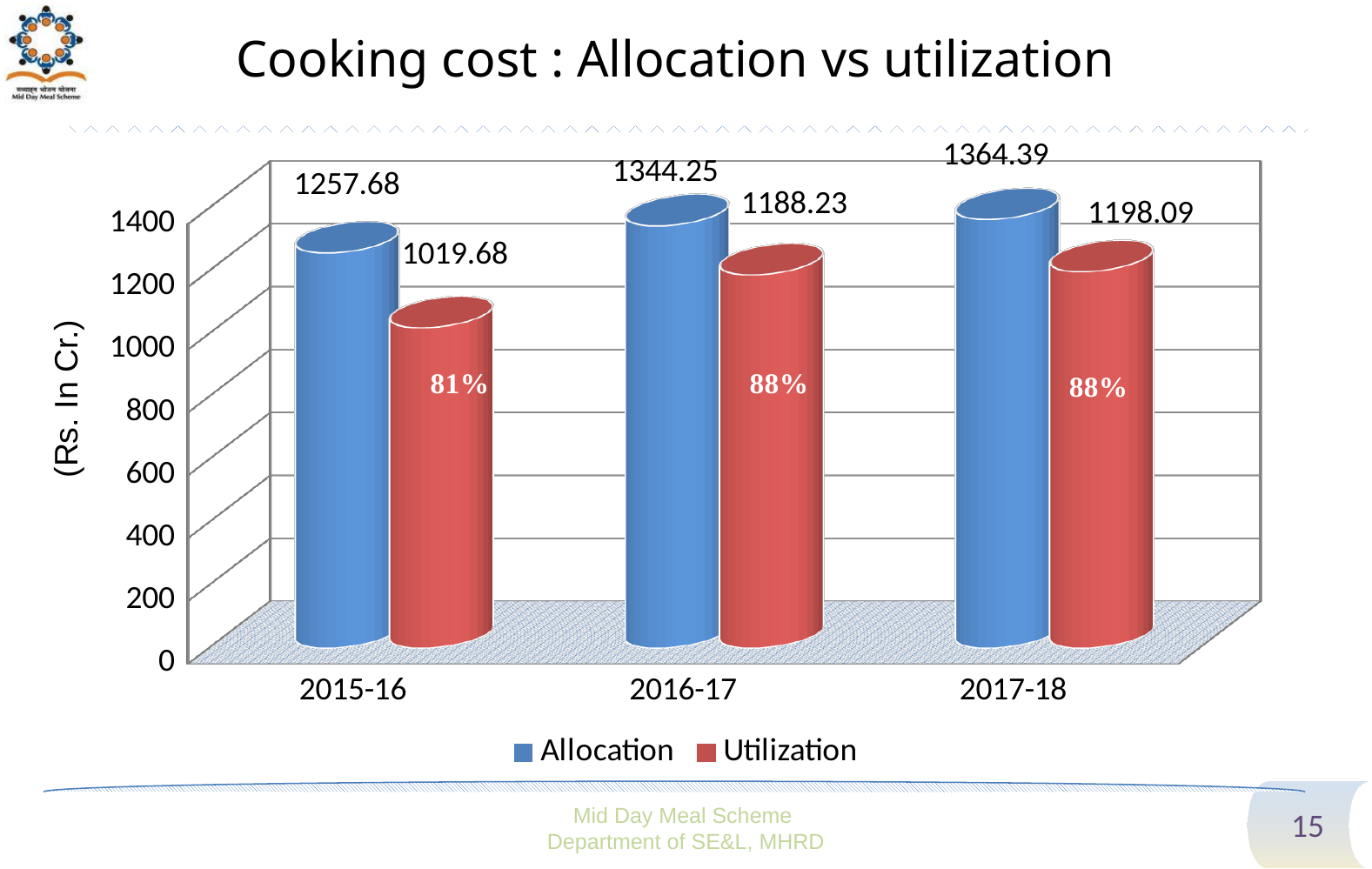
What is the Allocation value for 2015-16? 1257.68 Which is larger in 2016-17, Allocation or Utilization? Allocation What is the difference between Allocation and Utilization in 2015-16? 238.00 How many series does the legend list? 2 What kind of chart is shown on the slide? Bar chart Which year has the highest Allocation? 2017-18 Does the Allocation rise or fall from 2015-16 to 2017-18? Rise How many years are shown on the x axis? 3 What is the Utilization value for 2017-18? 1198.09 Which year has the lowest Utilization? 2015-16 What percentage label is shown on the Utilization bar for 2015-16? 81% What is the Utilization value for 2016-17? 1188.23